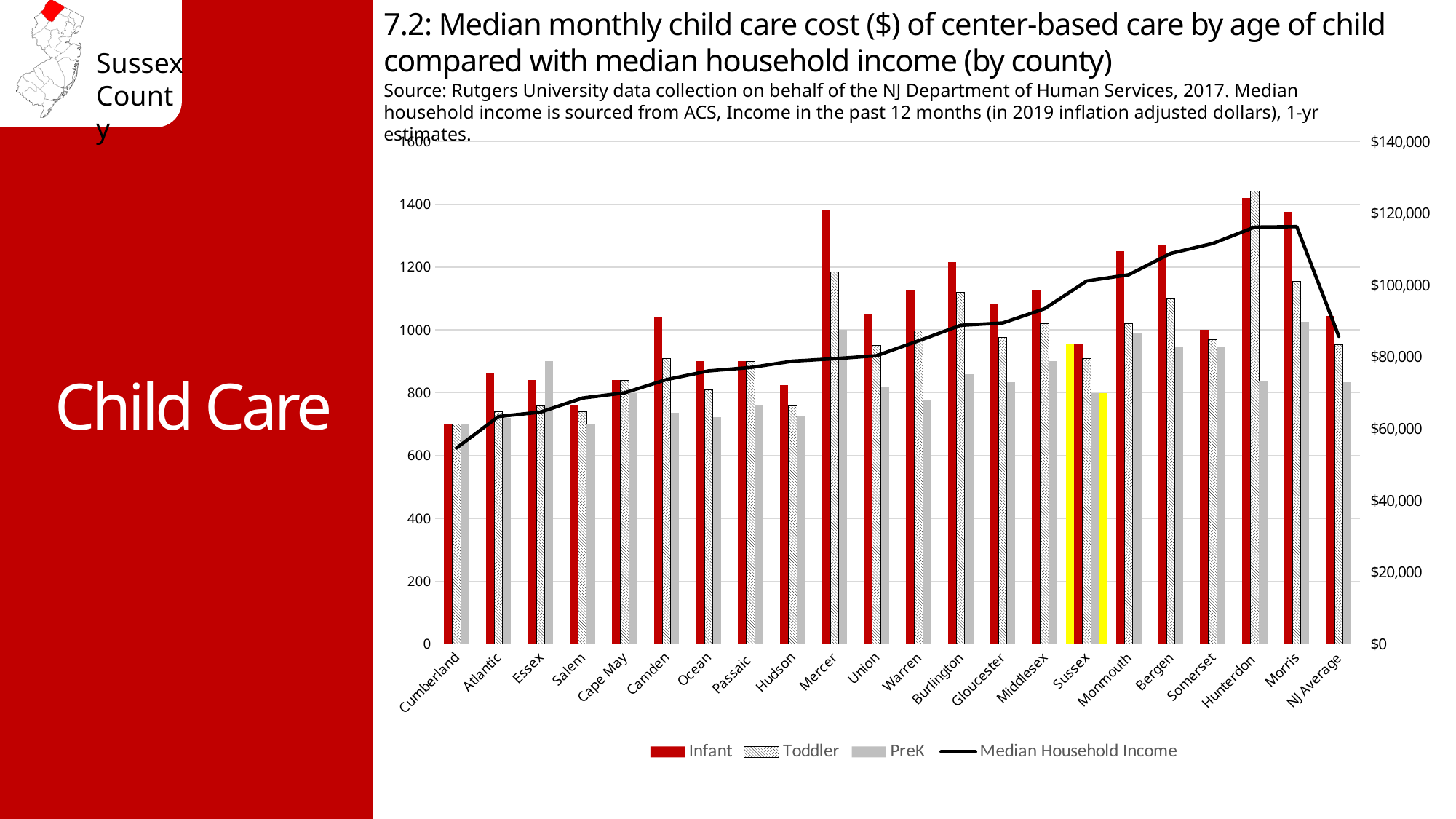
Is the Median Household Income for Morris greater or less than $100,000? greater Which is larger, the Infant value for Mercer or the Infant value for Union? Mercer Does the Median Household Income line generally rise or fall from Cumberland to Morris? rise Which county has the lowest Infant cost? Cumberland Is the Infant value for Mercer greater or less than 1200? greater Is the Median Household Income for Cumberland greater or less than $60,000? less Which county has the highest Toddler cost? Hunterdon Which series is drawn as a black line? Median Household Income What kind of chart is this? Bar chart with a line series How many categories are shown along the x axis? 22 How many series does the legend list? 4